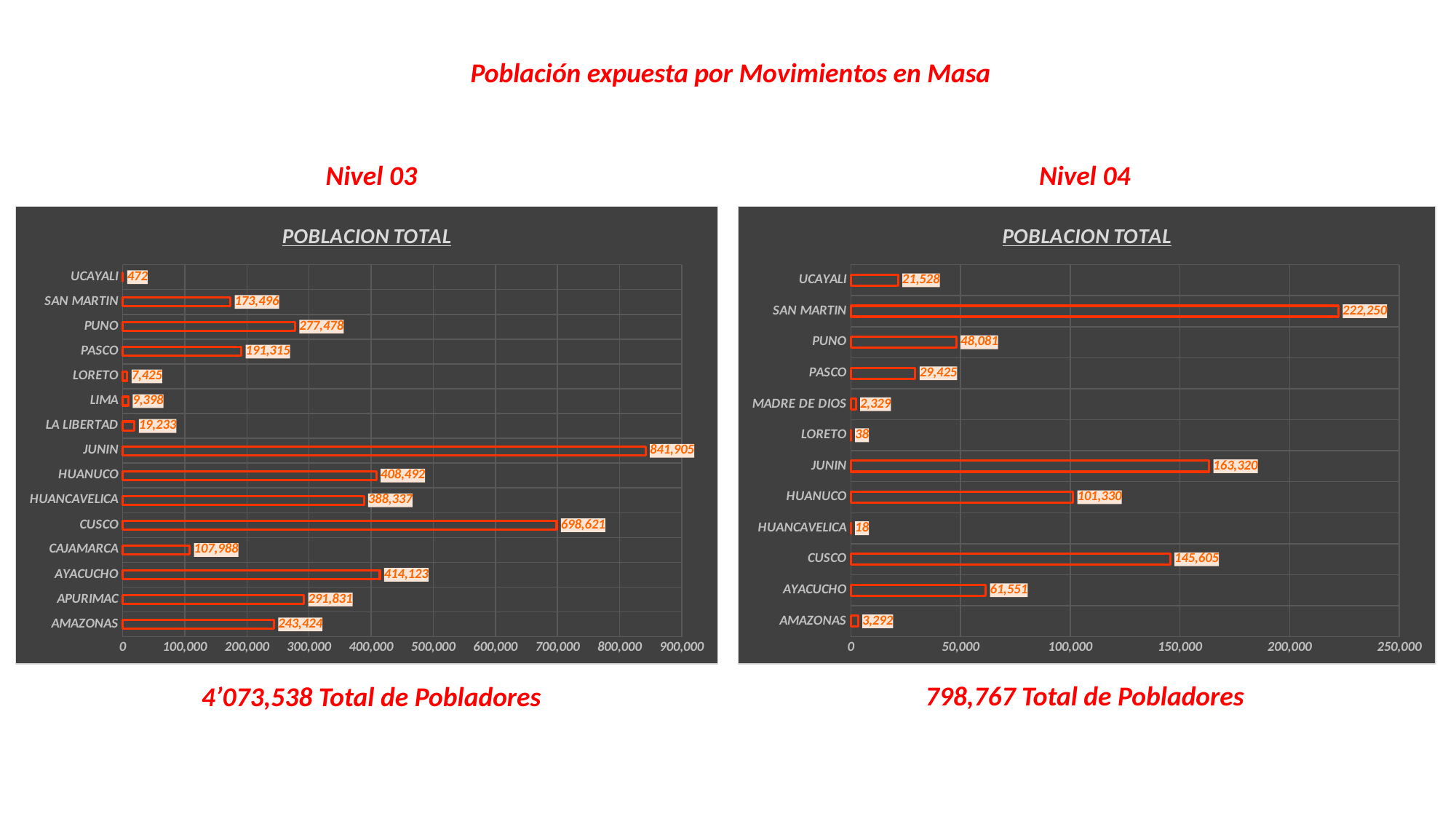
How many categories are shown in the Nivel 04 chart? 12 In the Nivel 04 chart, which category has the lowest value? HUANCAVELICA In the Nivel 03 chart, what is the value for AMAZONAS? 243,424 In the Nivel 03 chart, what is the difference between the values for JUNIN and CUSCO? 143,284 In the Nivel 03 chart, which category has the lowest value? UCAYALI What kind of chart is the Nivel 03 chart? Bar chart How many categories are shown in the Nivel 03 chart? 15 In the Nivel 04 chart, what is the difference between the values for SAN MARTIN and JUNIN? 58,930 In the Nivel 04 chart, what is the value for CUSCO? 145,605 In the Nivel 03 chart, which is larger, the value for PUNO or the value for PASCO? PUNO In the Nivel 04 chart, which category has the highest value? SAN MARTIN In the Nivel 03 chart, what is the value for JUNIN? 841,905